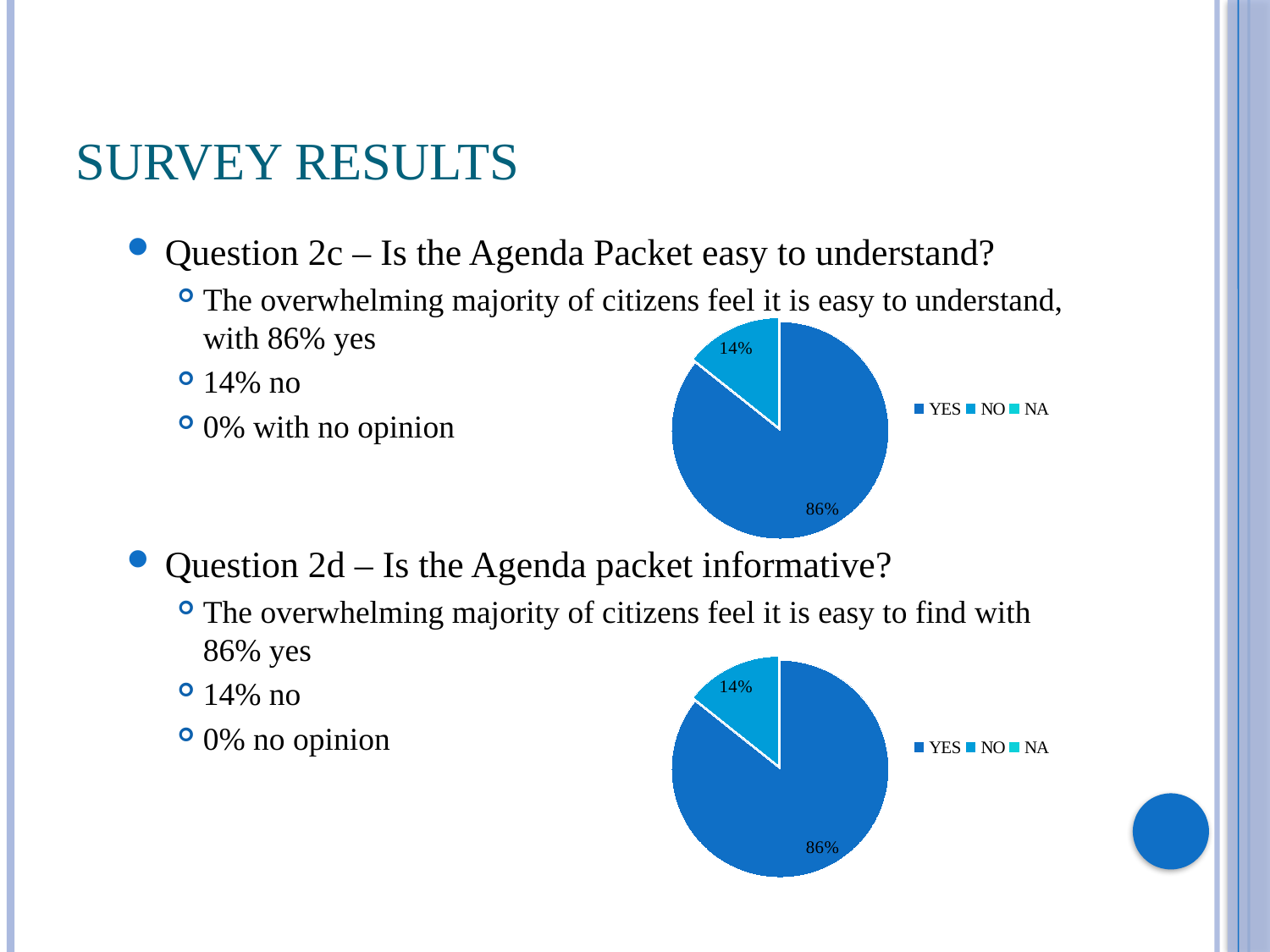
What are the legend entries of the lower pie chart (Question 2d)? YES, NO, NA What kind of chart is the upper chart on the slide, next to Question 2c? pie chart In the upper pie chart (Question 2c), what share of the pie is labelled for YES? 86% How many pie charts are shown on the slide? 2 In the lower pie chart (Question 2d), what share of the pie is labelled for NO? 14% In the upper pie chart (Question 2c), what share of the pie is labelled for NO? 14% In the lower pie chart (Question 2d), what is the difference between the YES share and the NO share? 72% In the upper pie chart (Question 2c), what is the difference between the YES share and the NO share? 72% In the upper pie chart (Question 2c), which slice is the largest? YES How many entries does the legend of the upper pie chart (Question 2c) list? 3 In the lower pie chart (Question 2d), which is larger, the YES slice or the NO slice? YES